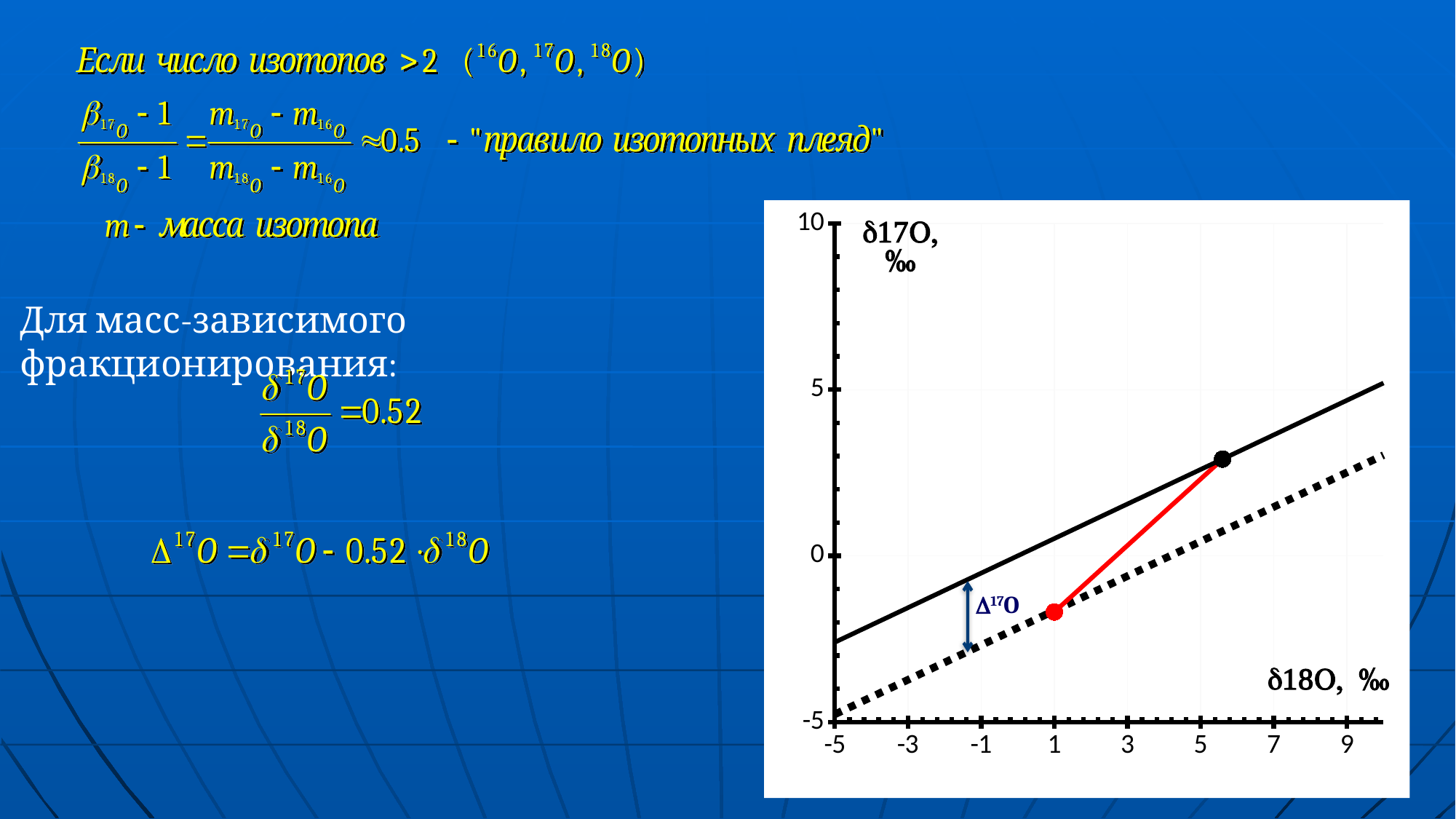
How many lines are plotted on the chart (excluding the red connecting segment)? 2 Do the values of the dashed line rise or fall as δ18O increases? rise Which point has the higher δ17O value, the red point or the black point? the black point Is the δ17O value of the black point greater or less than 0? greater Is the δ18O value of the black point greater or less than 3? greater What quantity is labelled by the arrow between the solid and dashed lines? Δ17O What is the label of the horizontal axis of the chart? δ18O, ‰ Is the δ17O value of the dashed line at δ18O = 9 greater or less than 5? less Do the values of the solid line rise or fall as δ18O increases? rise What kind of chart is shown on the slide? line chart